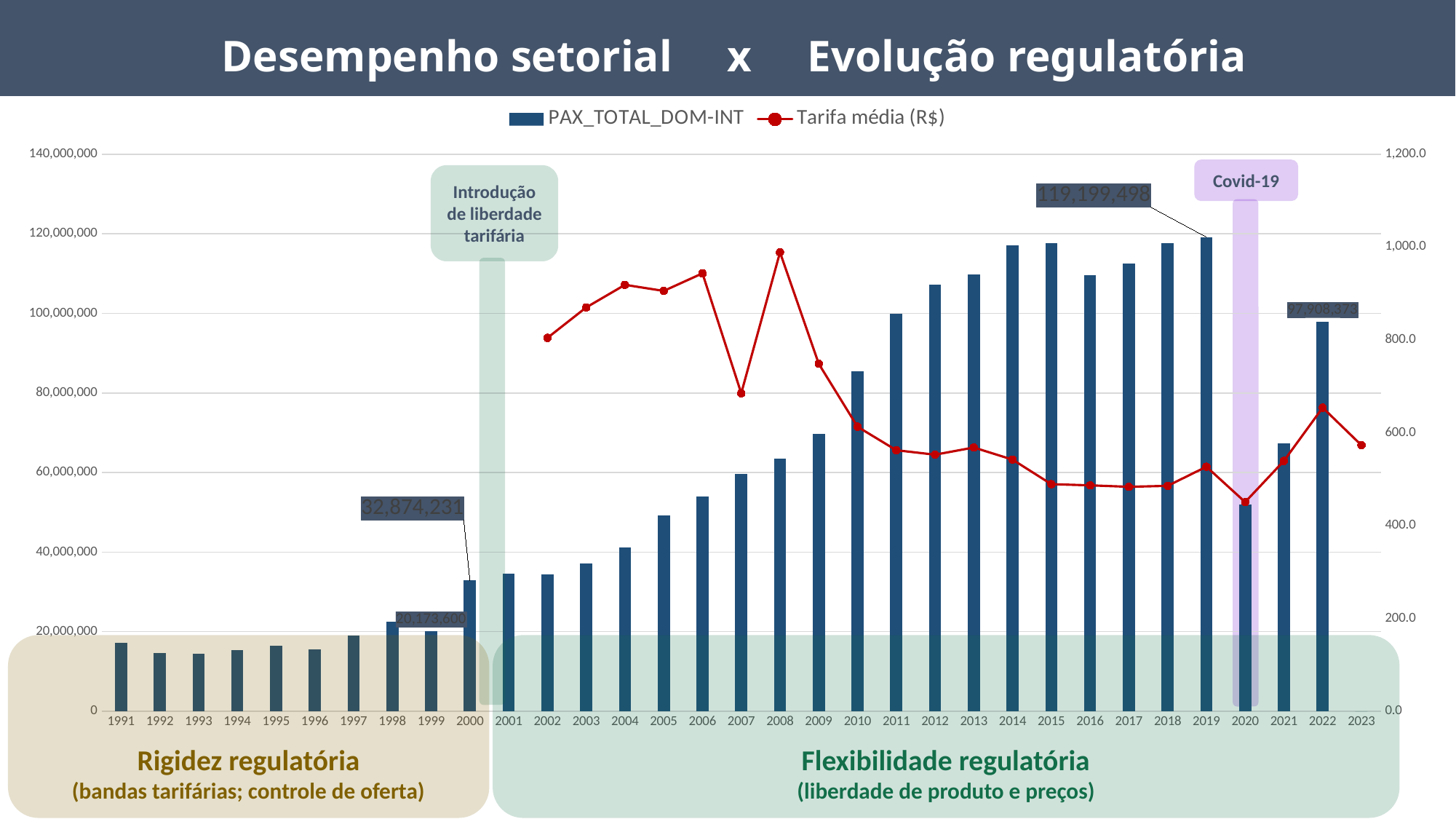
Which is larger, the Tarifa média (R$) value for 2007 or for 2008? 2008 Is the Tarifa média (R$) value for 2008 greater or less than 800.0? greater What is the PAX_TOTAL_DOM-INT value for 2022? 97,908,373 Is the PAX_TOTAL_DOM-INT value for 2020 greater or less than 60,000,000? less In which year does the Tarifa média (R$) line reach its lowest point? 2020 Does the Tarifa média (R$) line rise or fall from 2008 to 2015? fall Which year has the highest PAX_TOTAL_DOM-INT bar? 2019 In which year does the Tarifa média (R$) line reach its highest point? 2008 What is the difference between the PAX_TOTAL_DOM-INT values for 2019 and 2022? 21,291,125 What is the PAX_TOTAL_DOM-INT value for 2019? 119,199,498 How many series does the legend list? 2 What is the PAX_TOTAL_DOM-INT value for 2000? 32,874,231